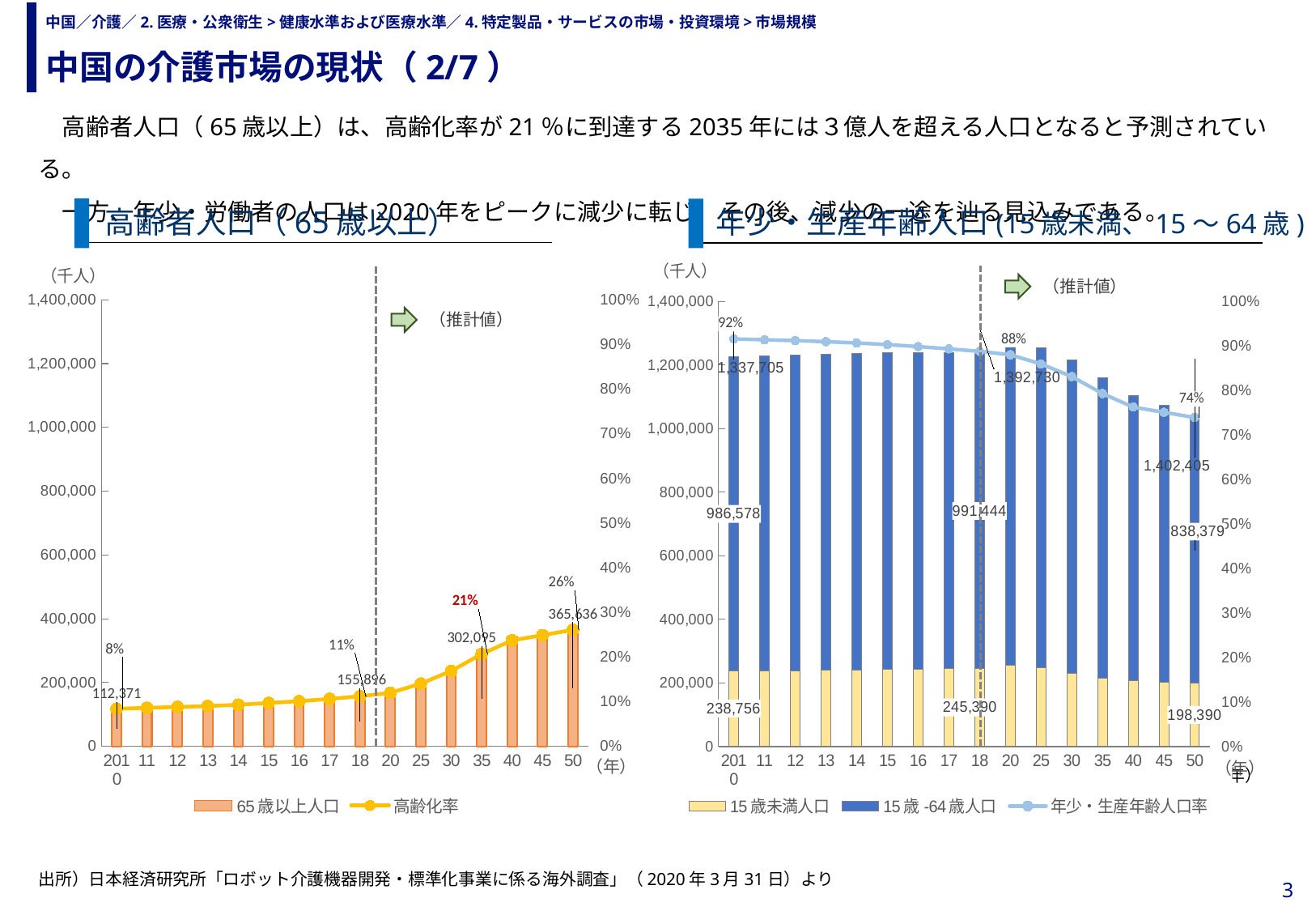
In the left chart (高齢者人口（65歳以上）), how many series does the legend list? 2 In the left chart (高齢者人口（65歳以上）), what is the difference between the 65歳以上人口 values for 2050 and 2010? 253,265 In the right chart (年少・生産年齢人口), what is the 15歳未満人口 value for 2050? 198,390 In the right chart (年少・生産年齢人口), what is the difference between the 15歳-64歳人口 values for 2018 and 2050? 153,065 In the left chart (高齢者人口（65歳以上）), is the 65歳以上人口 bar for 2040 greater or less than 200,000? greater In the left chart (高齢者人口（65歳以上）), what kind of chart is it? Bar chart with a line In the right chart (年少・生産年齢人口), how many series does the legend list? 3 In the left chart (高齢者人口（65歳以上）), what is the 65歳以上人口 value for 2035? 302,095 In the left chart (高齢者人口（65歳以上）), how many years are shown on the x axis? 16 In the right chart (年少・生産年齢人口), what is the 年少・生産年齢人口率 for 2018? 88% In the left chart (高齢者人口（65歳以上）), does the 高齢化率 line rise or fall from 2010 to 2050? Rises In the left chart (高齢者人口（65歳以上）), what is the 高齢化率 for 2050? 26%